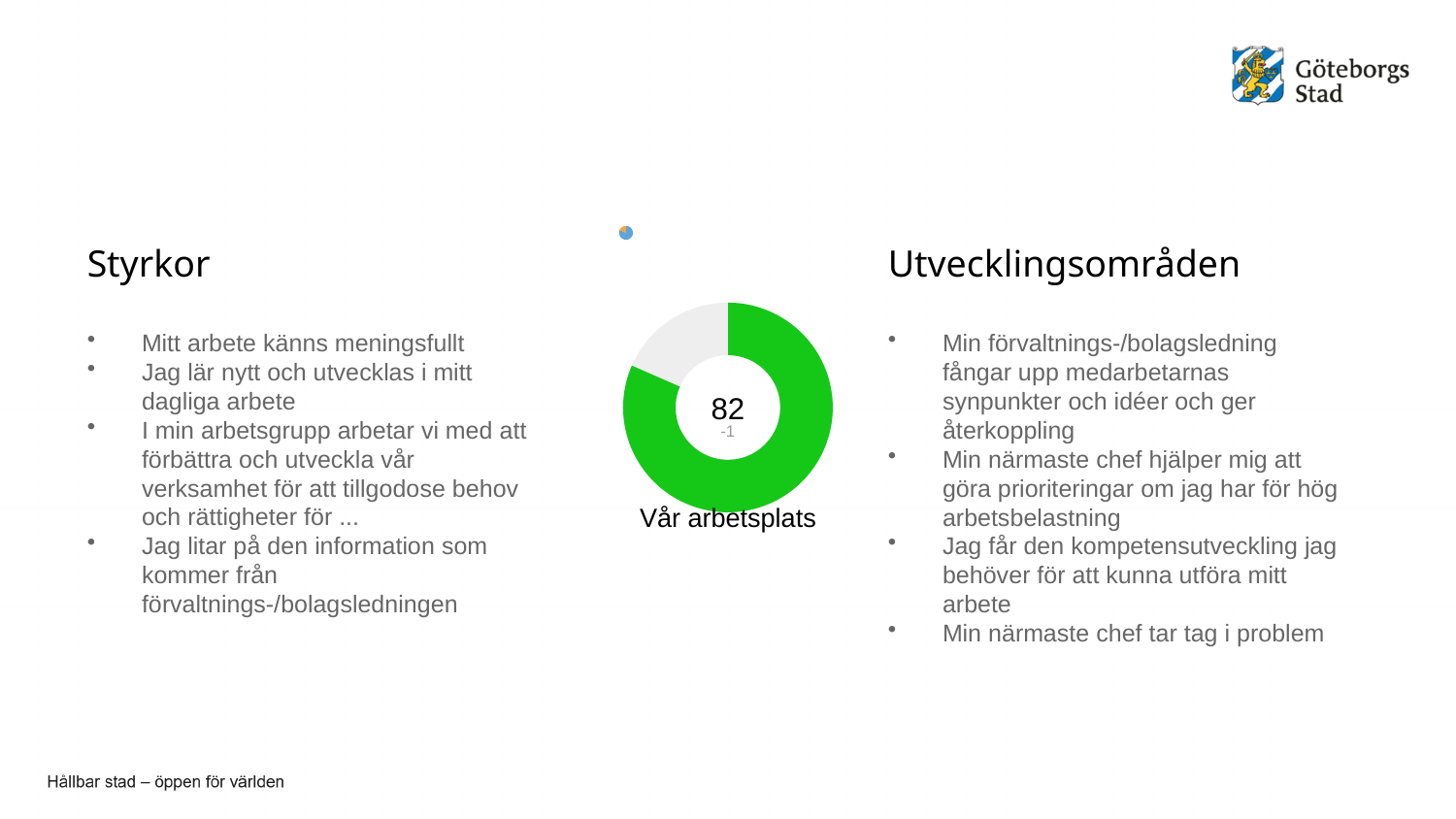
What kind of chart is shown in the middle of the slide? Donut chart What smaller number is printed beneath the 82 in the centre of the donut chart? -1 Which segment of the donut chart is larger, the green one or the grey one? The green one What colour is the largest segment of the donut chart? Green Is the value shown in the centre of the donut chart greater or less than 50? greater What label appears below the donut chart? Vår arbetsplats How many segments does the donut chart have? 2 What value is printed in the centre of the donut chart? 82